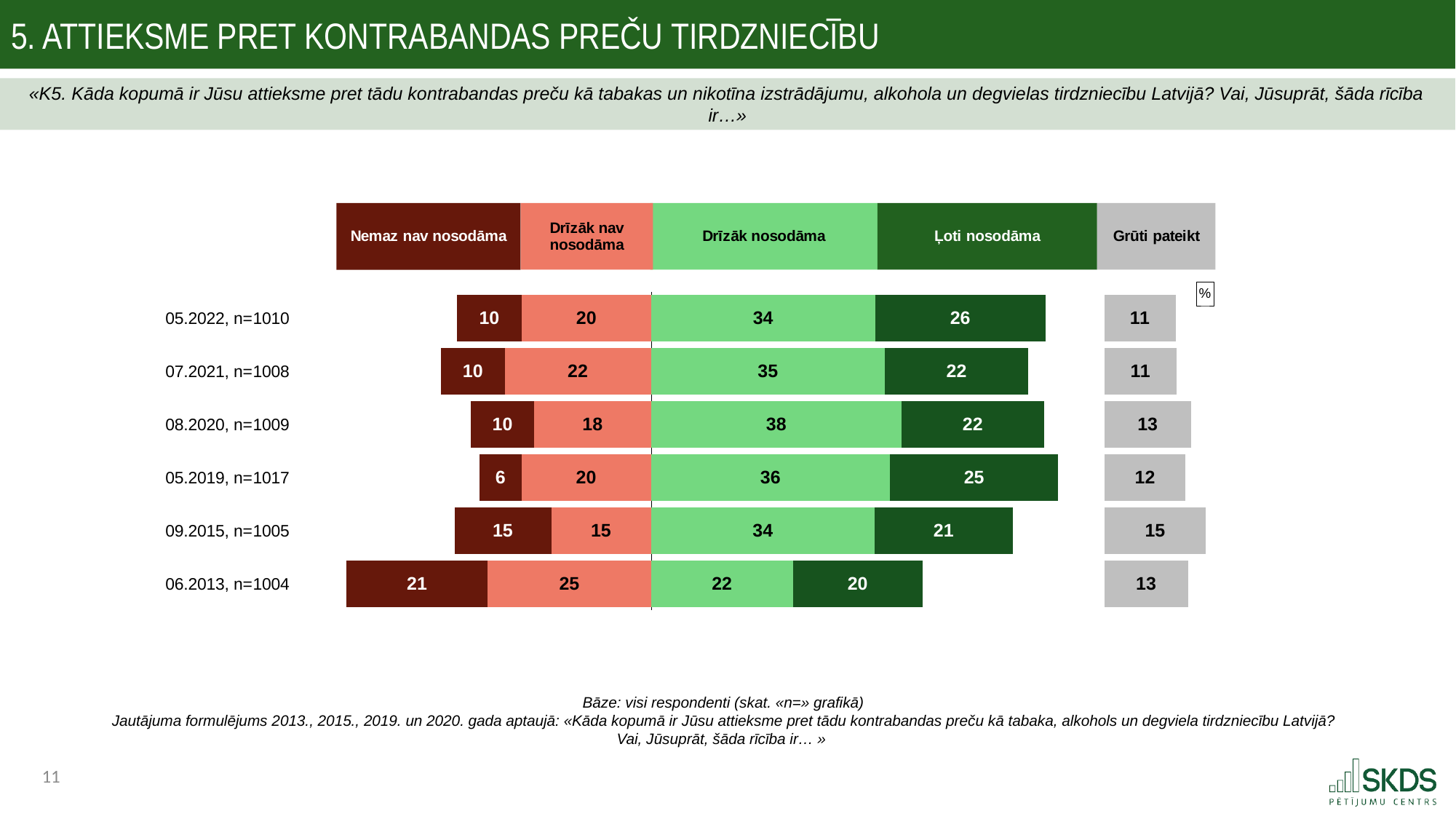
What is the total of the four coloured segments (excluding "Grūti pateikt") for the 09.2015 survey? 85 How many survey waves (rows) are shown in the chart? 6 What is the difference between the "Drīzāk nav nosodāma" values for 06.2013 and 08.2020? 7 What is the "Grūti pateikt" value for the 09.2015 survey (n=1005)? 15 What colour represents "Ļoti nosodāma" in the legend? Dark green Which survey has the larger "Ļoti nosodāma" value: 05.2019 or 07.2021? 05.2019 What kind of chart is shown on the slide? Stacked bar chart What percentage of respondents in the 08.2020 survey (n=1009) answered "Drīzāk nosodāma"? 38 Which survey wave has the lowest value for "Nemaz nav nosodāma"? 05.2019, n=1017 What is the value for "Ļoti nosodāma" in the 05.2022 survey (n=1010)? 26 Which survey wave has the highest value for "Nemaz nav nosodāma"? 06.2013, n=1004 How many response categories does the legend list? 5